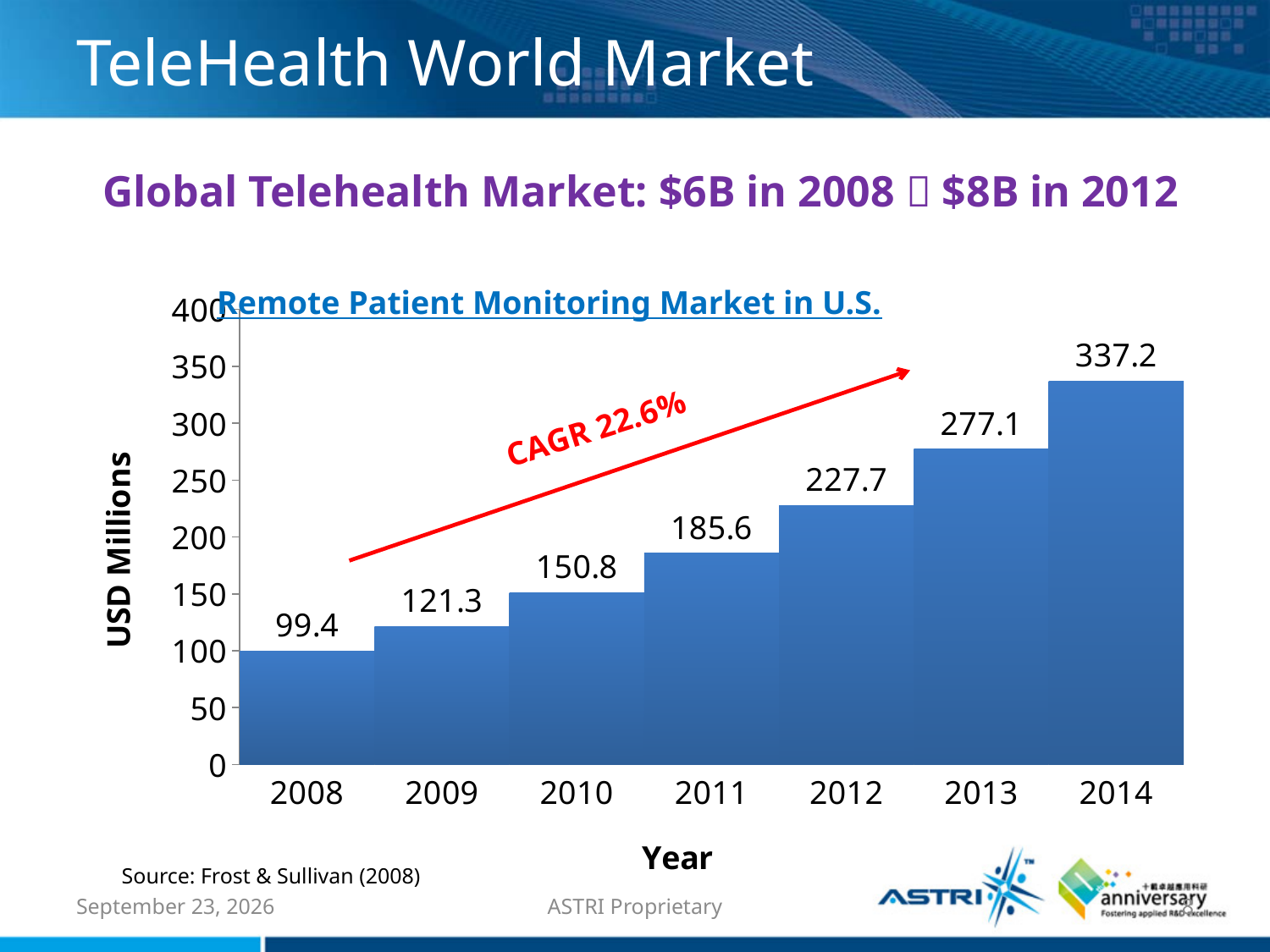
Which is larger in the Remote Patient Monitoring Market in U.S. chart, the value for 2010 or the value for 2012? 2012 What is the difference between the 2014 and 2008 values in the Remote Patient Monitoring Market in U.S. chart? 237.8 Do the values in the Remote Patient Monitoring Market in U.S. chart rise or fall from 2008 to 2014? rise How many years are shown on the x axis of the Remote Patient Monitoring Market in U.S. chart? 7 Which year has the highest value in the Remote Patient Monitoring Market in U.S. chart? 2014 What kind of chart is the Remote Patient Monitoring Market in U.S. chart? bar chart What is the value for 2008 in the Remote Patient Monitoring Market in U.S. chart? 99.4 Which year has the lowest value in the Remote Patient Monitoring Market in U.S. chart? 2008 Is the value for 2012 in the Remote Patient Monitoring Market in U.S. chart greater or less than 200? greater What is the value for 2013 in the Remote Patient Monitoring Market in U.S. chart? 277.1 What is the value for 2011 in the Remote Patient Monitoring Market in U.S. chart? 185.6 What CAGR is annotated on the Remote Patient Monitoring Market in U.S. chart? 22.6%